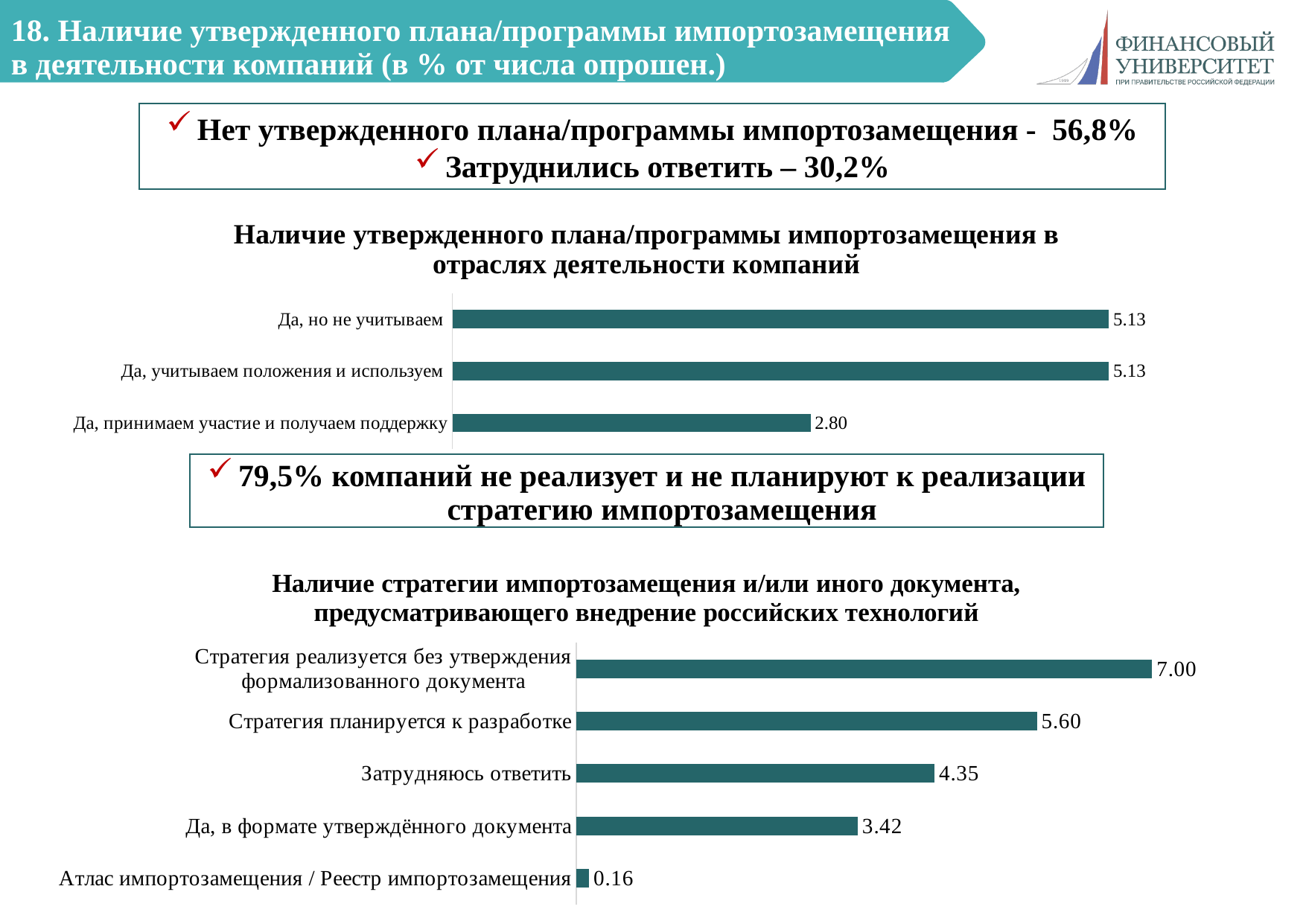
In the top chart, which category has the lowest value? Да, принимаем участие и получаем поддержку In the bottom chart, what is the value for "Атлас импортозамещения / Реестр импортозамещения"? 0.16 What type of chart is the bottom chart? Bar chart In the top chart, what is the value for "Да, но не учитываем"? 5.13 In the bottom chart, how many categories are plotted? 5 In the bottom chart, which category has the lowest value? Атлас импортозамещения / Реестр импортозамещения In the bottom chart, what is the value for "Стратегия планируется к разработке"? 5.60 In the top chart, what is the value for "Да, принимаем участие и получаем поддержку"? 2.80 In the top chart, how many categories are plotted? 3 In the bottom chart, which is larger: "Затрудняюсь ответить" or "Да, в формате утверждённого документа"? Затрудняюсь ответить In the top chart, what is the difference between "Да, учитываем положения и используем" and "Да, принимаем участие и получаем поддержку"? 2.33 In the bottom chart, which category has the highest value? Стратегия реализуется без утверждения формализованного документа